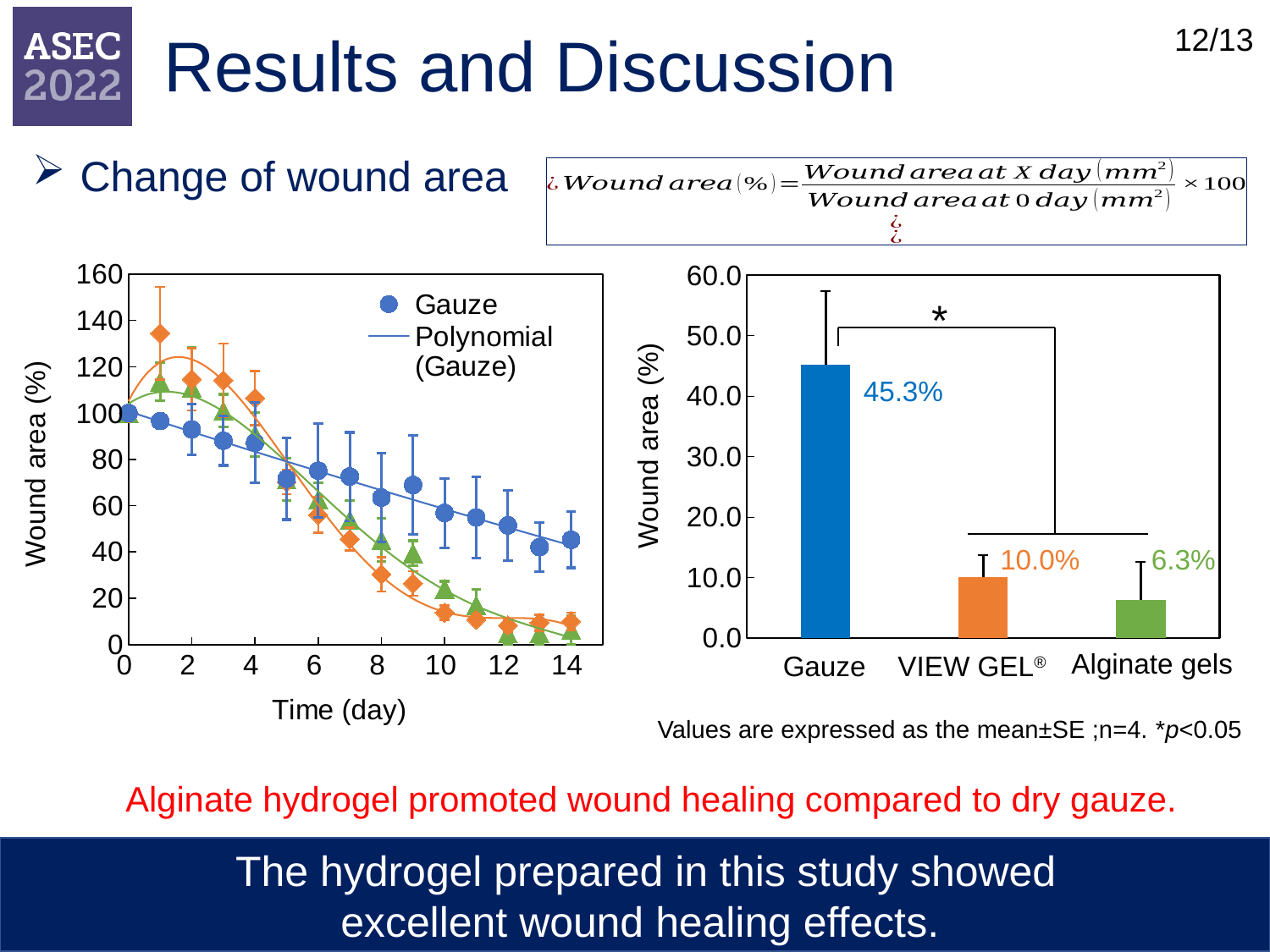
In the bar chart on the right, what is the wound area value for Alginate gels? 6.3% In the bar chart on the right, what is the wound area value for Gauze? 45.3% In the bar chart on the right, which category has the lowest wound area? Alginate gels In the bar chart on the right, which is larger, the wound area for VIEW GEL® or for Alginate gels? VIEW GEL® In the bar chart on the right, what is the difference between the wound area for Gauze and for VIEW GEL®? 35.3% What kind of chart is the chart on the right of the slide? Bar chart In the chart on the left, is the Gauze wound area at day 14 greater or less than 60? less In the chart on the left, what is the label of the x axis? Time (day) In the bar chart on the right, what is the wound area value for VIEW GEL®? 10.0% In the chart on the left, does the Gauze wound area rise or fall from day 4 to day 14? Fall In the bar chart on the right, how many categories are shown on the x axis? 3 In the bar chart on the right, which category has the highest wound area? Gauze